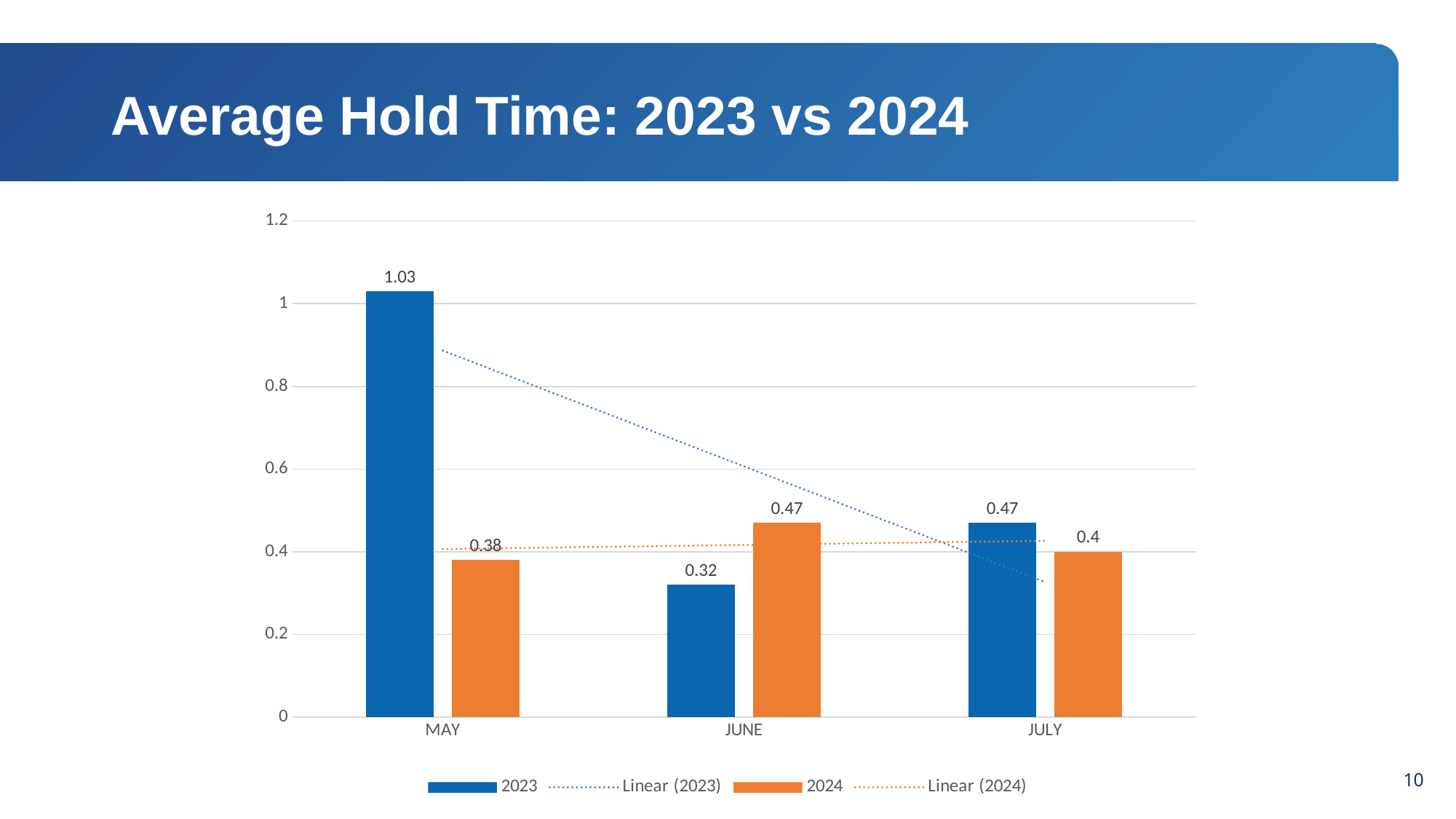
Which month has the lowest 2024 value? May Which month has the lowest 2023 value? June What kind of chart is shown on the slide? Bar chart How many entries does the legend list? 4 How many months are shown on the x axis? 3 What is the 2023 value for June? 0.32 What is the 2024 value for June? 0.47 What is the difference between the 2023 and 2024 values for May? 0.65 Which is larger for June, the 2023 value or the 2024 value? 2024 Which month has the highest 2023 value? May What is the 2024 value for July? 0.4 What is the 2023 value for May? 1.03